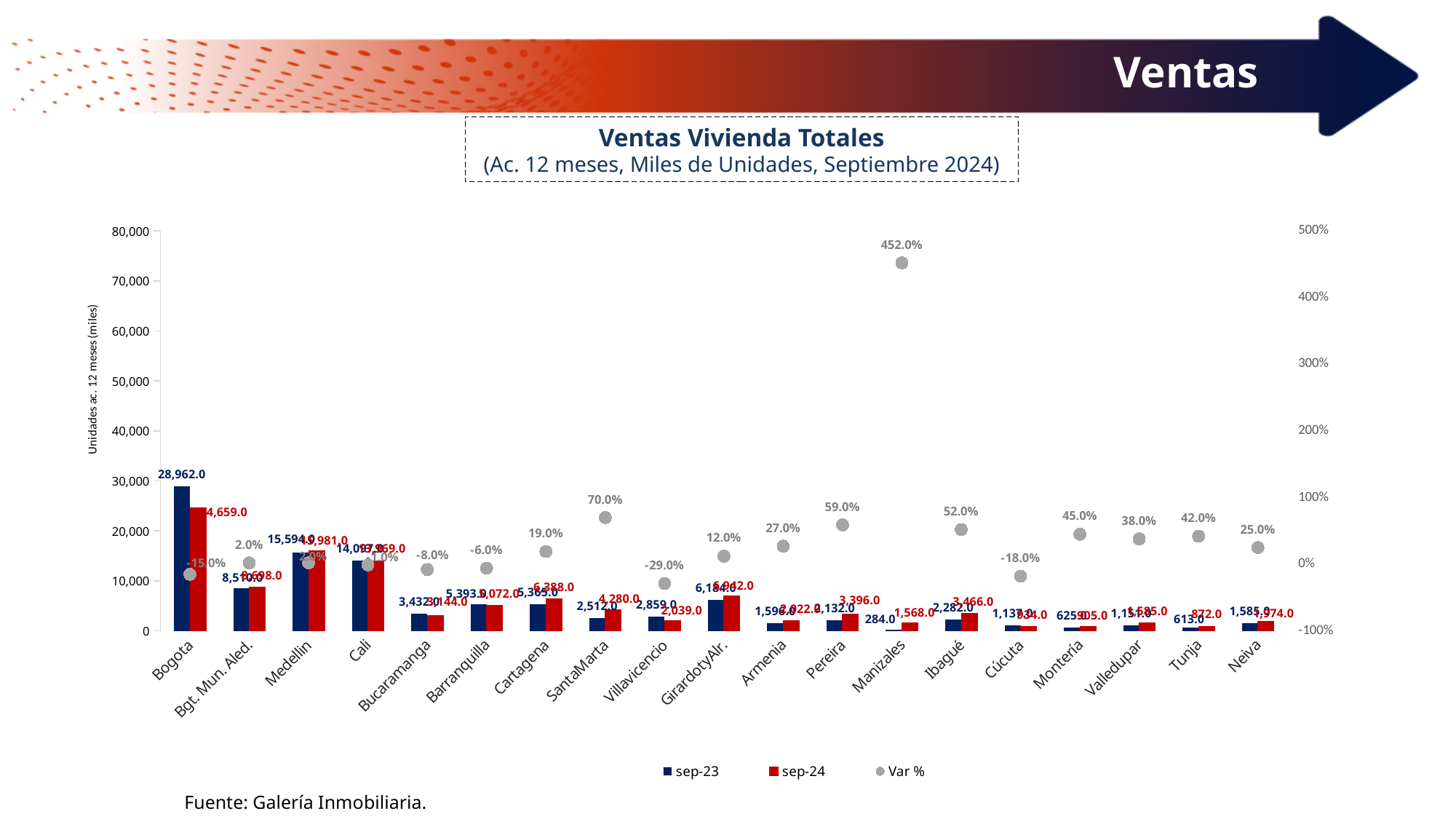
What is the Var % value for Villavicencio? -29.0% What is the sep-24 value for Cartagena? 6,388.0 What is the Var % value for Manizales? 452.0% What is the sep-23 value for Bogota? 28,962.0 How many cities are shown on the x axis? 19 What is the difference between the sep-24 and sep-23 values for SantaMarta? 1,768.0 Is the sep-23 value for Bogota greater or less than 20,000? greater How many series does the legend list? 3 Which city has the highest Var % value? Manizales Which is larger for Pereira, the sep-23 value or the sep-24 value? sep-24 Which city has the lowest sep-23 value? Manizales What kind of chart is used to show the sep-23 and sep-24 series? bar chart